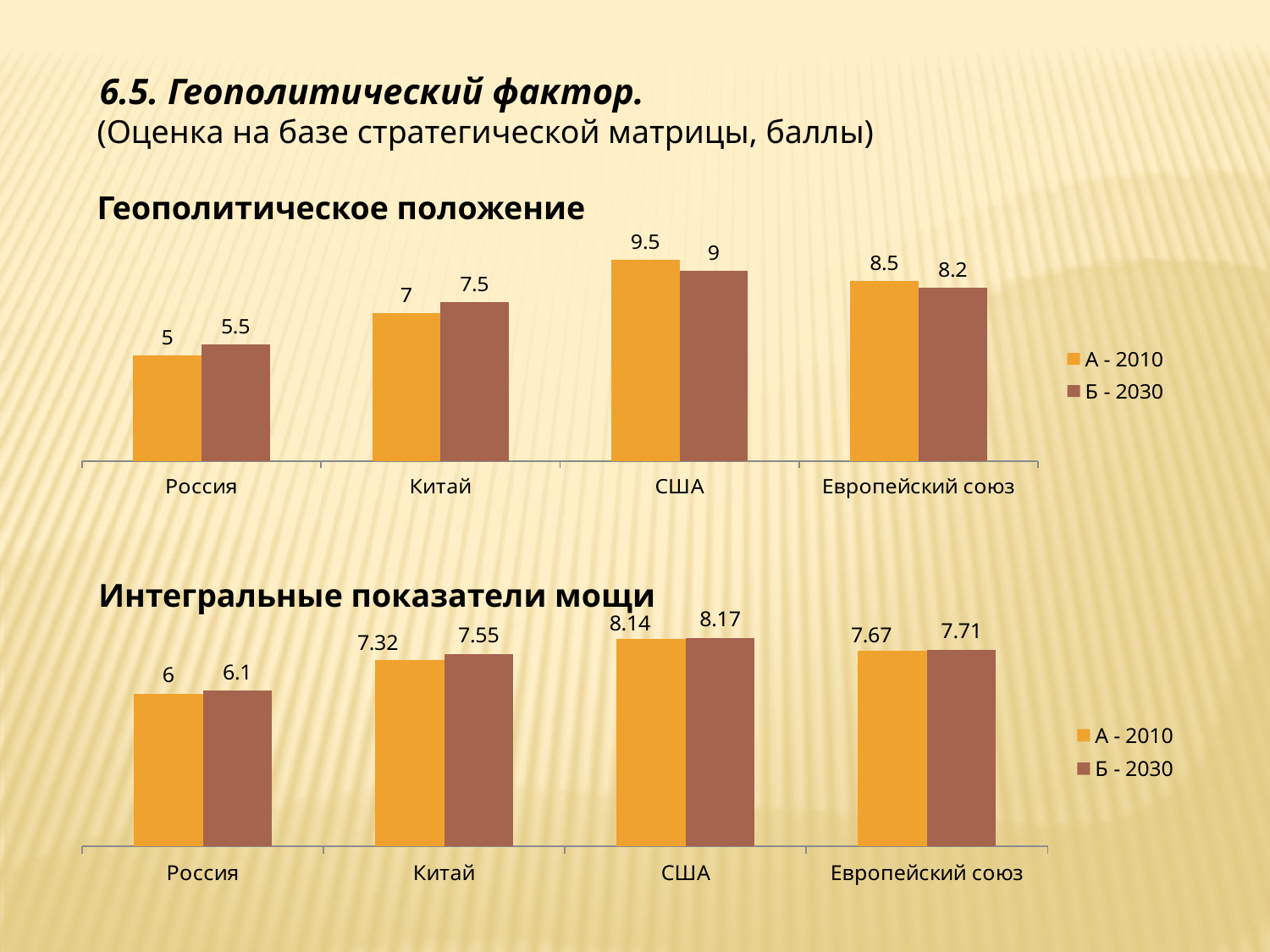
In the chart titled "Интегральные показатели мощи", which category has the lowest value in the series Б - 2030? Россия In the chart titled "Интегральные показатели мощи", what is the value for Китай in the series Б - 2030? 7.55 In the chart titled "Интегральные показатели мощи", what is the difference between the Б - 2030 and А - 2010 values for Китай? 0.23 In the chart titled "Интегральные показатели мощи", what is the value for Европейский союз in the series А - 2010? 7.67 In the chart titled "Геополитическое положение", which category has the highest value in the series А - 2010? США In the chart titled "Геополитическое положение", which is larger for Европейский союз: the А - 2010 value or the Б - 2030 value? А - 2010 In the chart titled "Геополитическое положение", what is the difference between the А - 2010 and Б - 2030 values for Китай? 0.5 How many categories are shown on the x axis of the chart titled "Интегральные показатели мощи"? 4 In the chart titled "Геополитическое положение", what is the value for США in the series А - 2010? 9.5 In the chart titled "Геополитическое положение", what is the value for Россия in the series Б - 2030? 5.5 What kind of chart is the chart titled "Интегральные показатели мощи"? Bar chart How many series does the legend of the chart titled "Геополитическое положение" list? 2